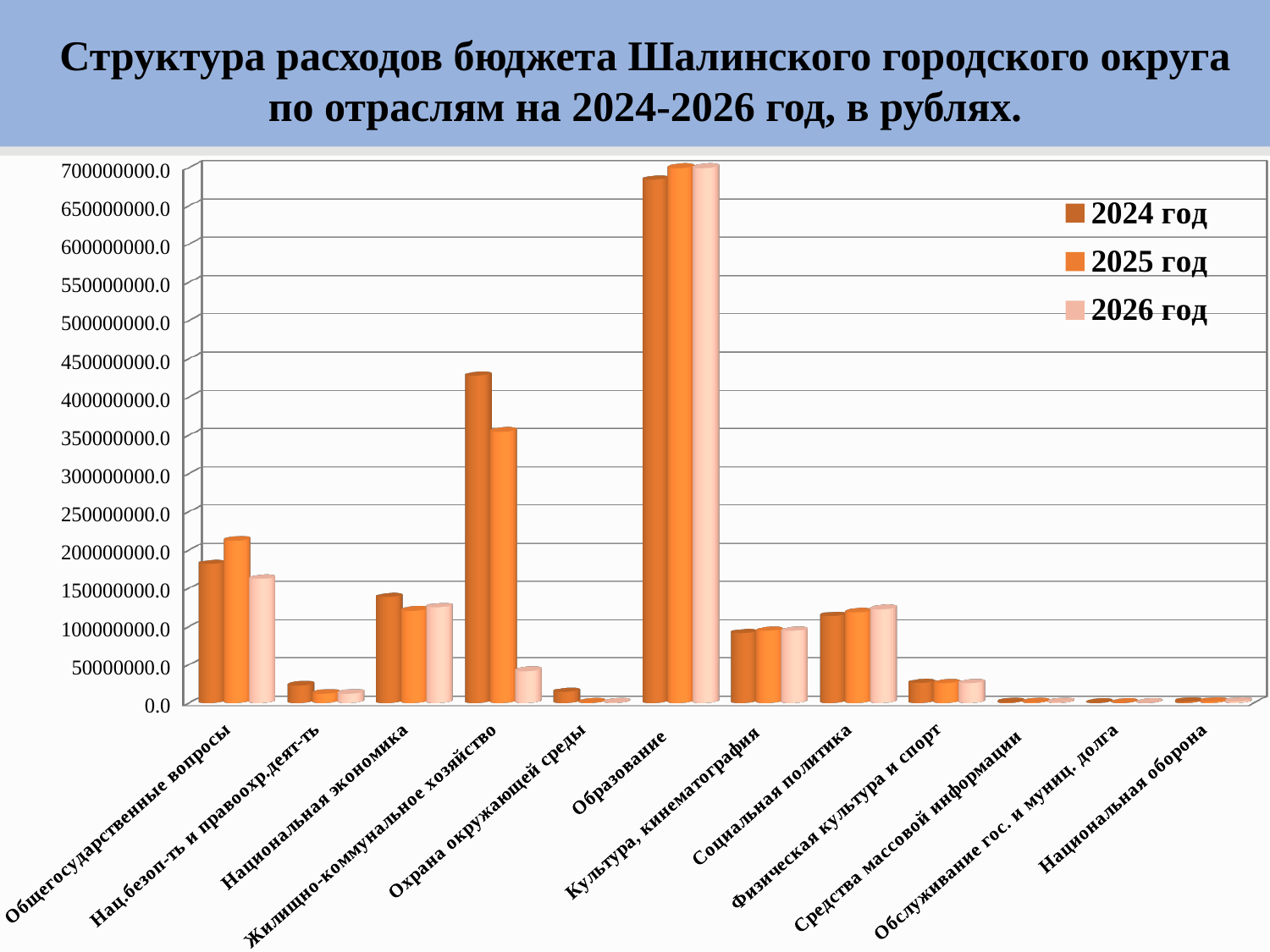
Do the values for Жилищно-коммунальное хозяйство rise or fall from 2024 год to 2026 год? fall Is the value for Жилищно-коммунальное хозяйство in 2024 год greater or less than 400000000.0? greater For Жилищно-коммунальное хозяйство, which year has the larger value: 2024 год or 2025 год? 2024 год How many series does the legend list? 3 Is the value for Образование in 2024 год greater or less than 650000000.0? greater Is the value for Жилищно-коммунальное хозяйство in 2026 год greater or less than 50000000.0? less For Общегосударственные вопросы, which year has the larger value: 2024 год or 2025 год? 2025 год Which category has the highest value for 2024 год? Образование How many categories are shown on the x axis? 12 What are the three entries listed in the legend? 2024 год, 2025 год, 2026 год What kind of chart is shown on the slide? bar chart